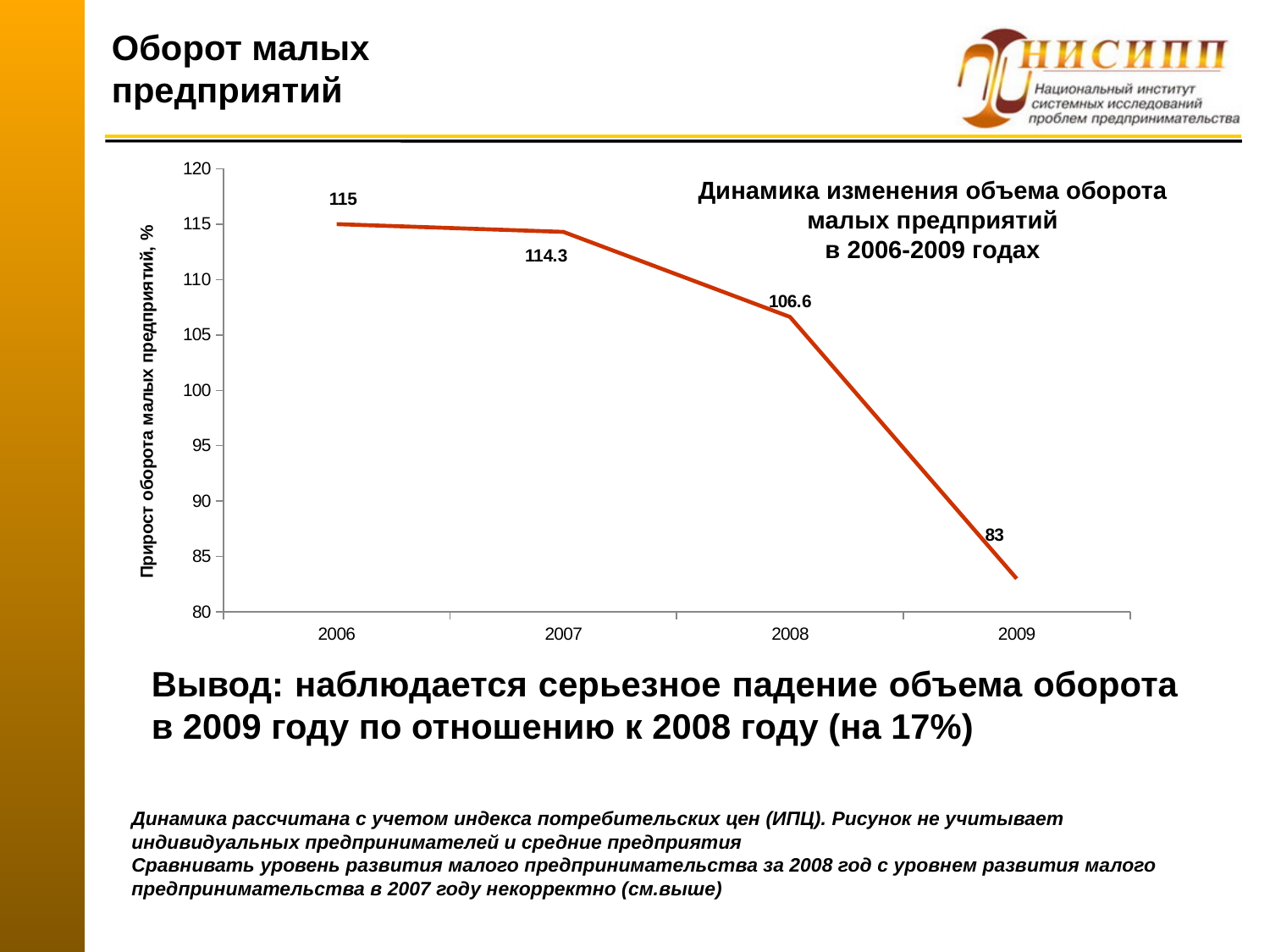
How many years are plotted on the chart? 4 What is the value for 2007? 114.3 What kind of chart is shown? line chart Which year has the highest value? 2006 What is the value for 2009? 83 Is the value for 2009 greater or less than 90? less Which year has the lowest value? 2009 What is the value for 2008? 106.6 What is the value for 2006? 115 Do the values rise or fall from 2006 to 2009? fall What is the difference between the values for 2008 and 2009? 23.6 Which is larger, the value for 2007 or the value for 2008? 2007